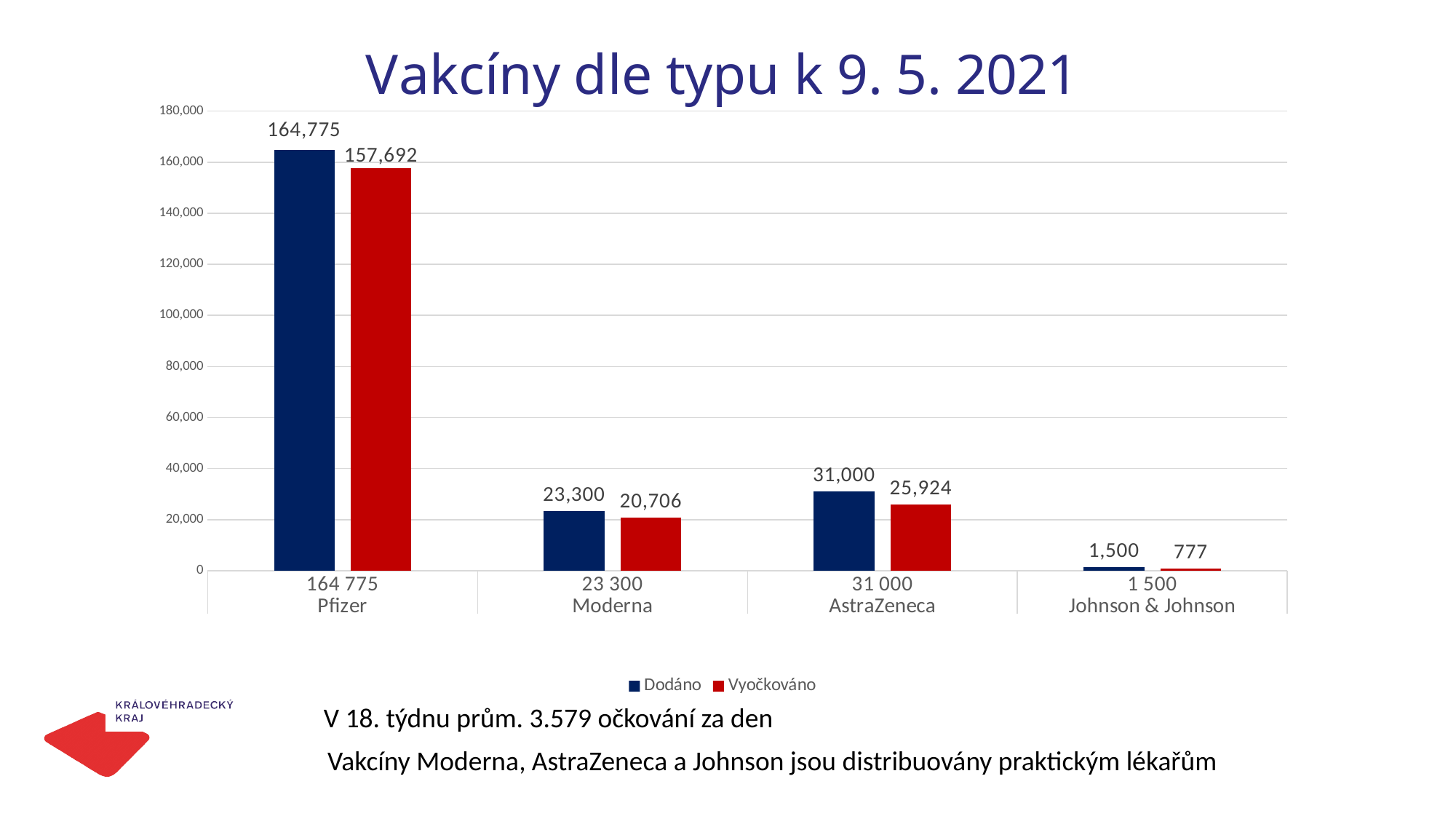
Which vaccine type has the highest Dodáno value? Pfizer Which vaccine type has the lowest Vyočkováno value? Johnson & Johnson How many vaccine types are shown on the x axis? 4 What is the difference between the Dodáno and Vyočkováno values for AstraZeneca? 5,076 Which is larger: the Dodáno value for AstraZeneca or the Dodáno value for Moderna? AstraZeneca What is the Vyočkováno value for Johnson & Johnson? 777 What is the Dodáno value for Moderna? 23,300 What is the Vyočkováno value for AstraZeneca? 25,924 What is the Dodáno value for Pfizer? 164,775 What type of chart is shown on the slide? Bar chart What is the difference between the Dodáno and Vyočkováno values for Pfizer? 7,083 How many series does the legend list? 2